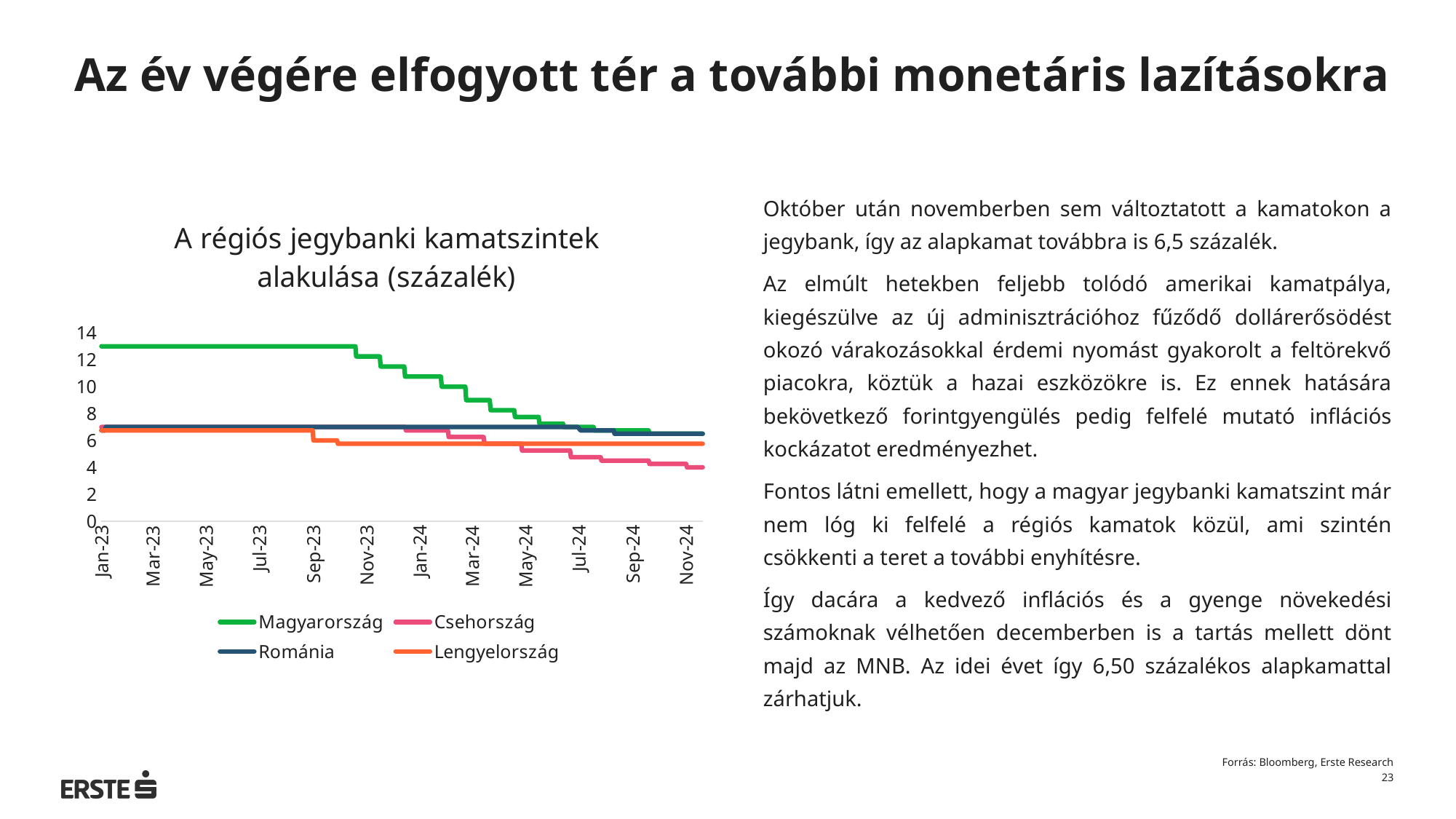
Is the value for Magyarország in Nov-24 greater or less than 8? less Is the value for Románia in Jan-23 greater or less than 6? greater In Nov-24, which is higher: Románia or Csehország? Románia Which colour is used for the Lengyelország line? orange Does the Magyarország line rise or fall from Jan-23 to Nov-24? fall Is the value for Magyarország in Jan-23 greater or less than 12? greater Which country has the lowest central bank rate in Nov-24? Csehország What is the title of the chart? A régiós jegybanki kamatszintek alakulása (százalék) Which country has the highest central bank rate in Jan-23? Magyarország What kind of chart is shown on the slide? line chart How many series does the chart's legend list? 4